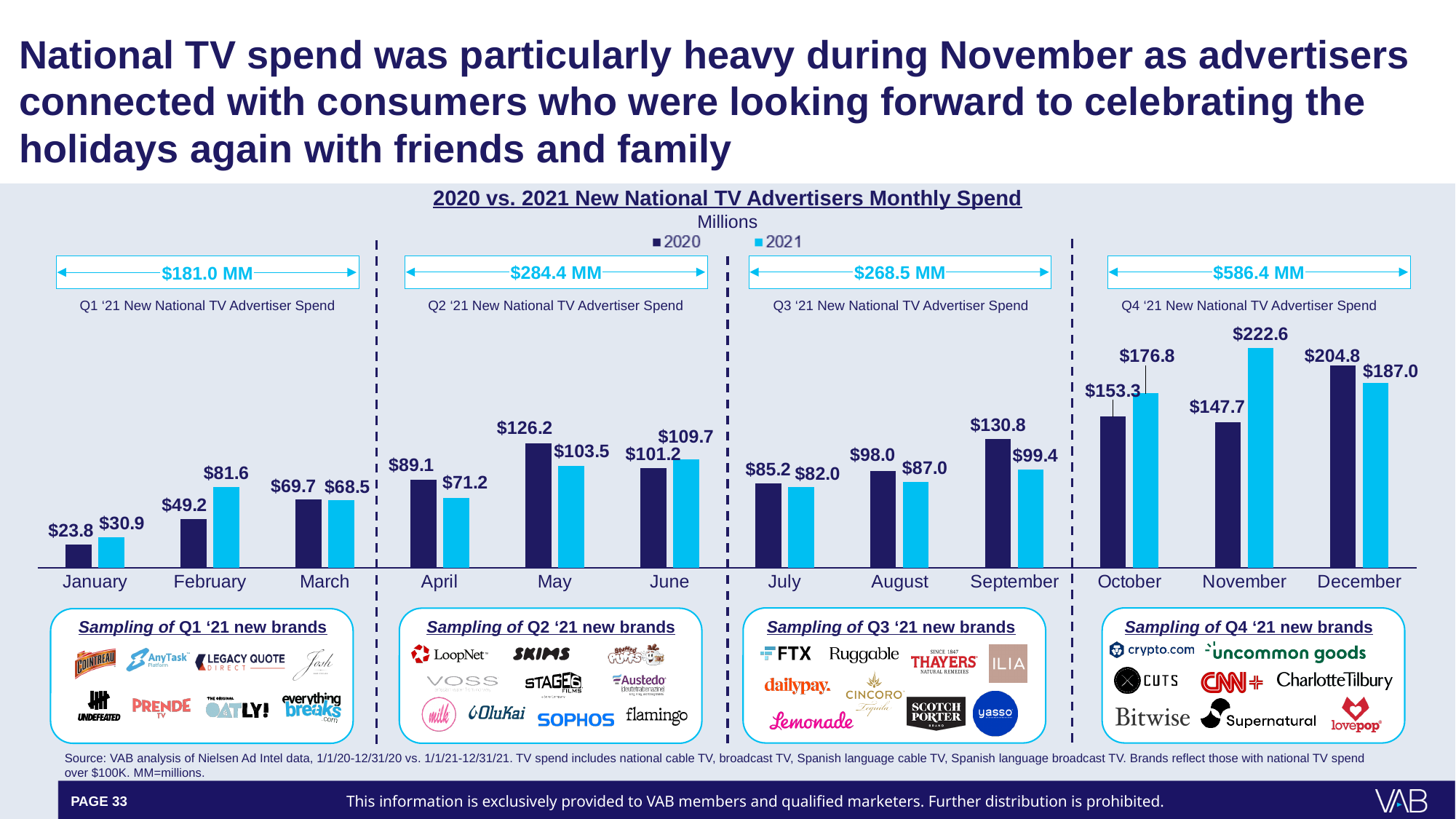
What kind of chart is used to show the monthly spend? Bar chart What is the difference between the 2021 and 2020 spend in November? $74.9 Which month had the highest 2021 new national TV advertiser spend? November What was the 2021 new national TV advertiser spend in November? $222.6 In December, which year had the higher new national TV advertiser spend, 2020 or 2021? 2020 How many series does the chart's legend list? 2 What is the title of the chart? 2020 vs. 2021 New National TV Advertisers Monthly Spend What was the 2020 new national TV advertiser spend in May? $126.2 Which month had the lowest 2020 new national TV advertiser spend? January What is the Q4 '21 new national TV advertiser spend total shown above the chart? $586.4 MM Does the 2021 spend rise or fall from January to February? Rise How many months are shown on the x axis of the chart? 12